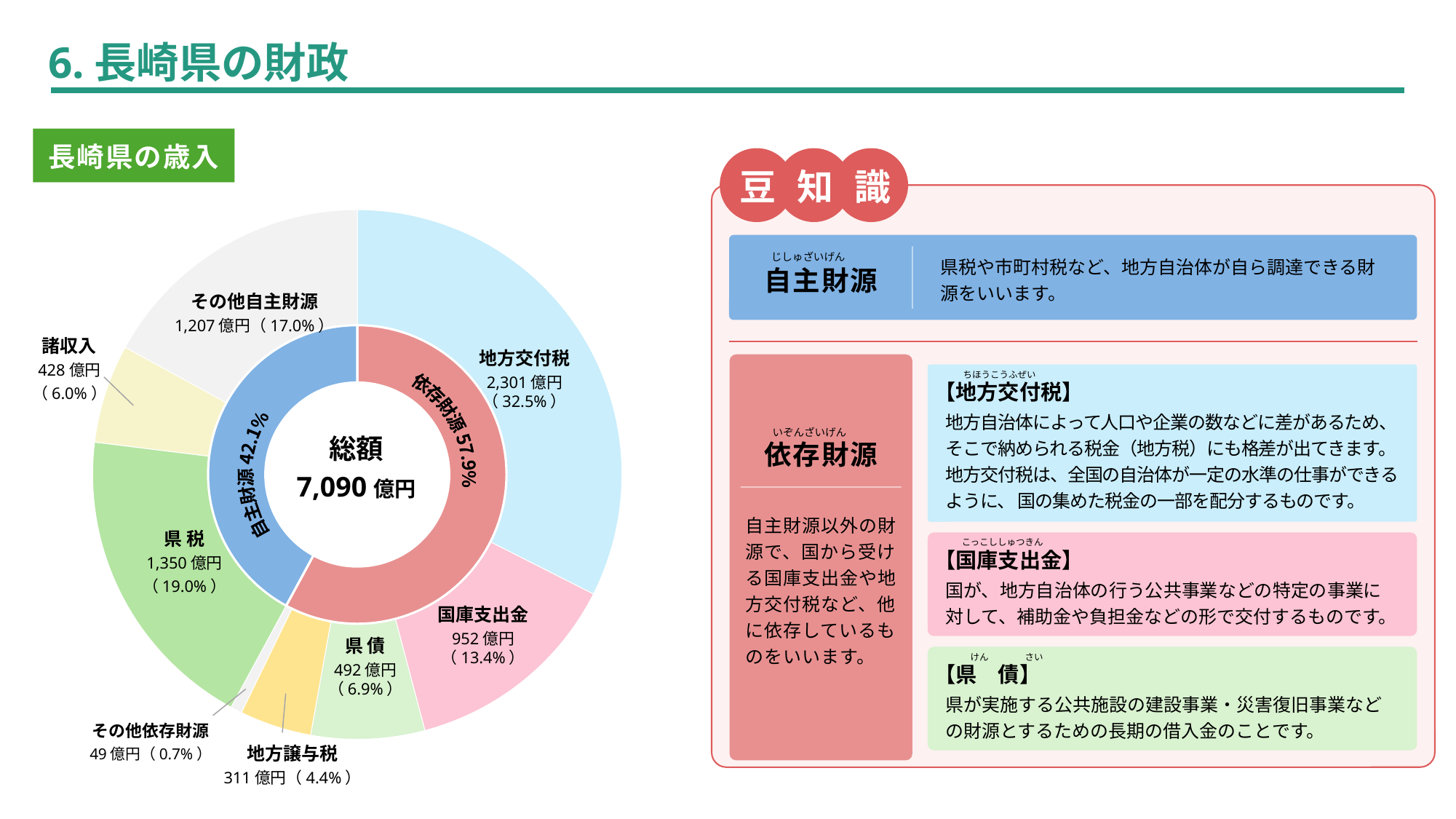
What kind of chart is the 長崎県の歳入 chart? Donut (pie) chart What is the total amount shown in the centre of the 長崎県の歳入 chart? 7,090 億円 Which category has the smallest value in the 長崎県の歳入 chart? その他依存財源 What is the difference between 地方交付税 and 県税 in the 長崎県の歳入 chart? 951 億円 What percentage of the total is 自主財源 in the 長崎県の歳入 chart? 42.1% Which is larger in the 長崎県の歳入 chart, 国庫支出金 or その他自主財源? その他自主財源 Which category has the largest value in the 長崎県の歳入 chart? 地方交付税 What is the value for 地方譲与税 in the 長崎県の歳入 chart? 311 億円 What percentage of the total is 依存財源 in the 長崎県の歳入 chart? 57.9% How many categories are shown in the outer ring of the 長崎県の歳入 chart? 8 What is the value for 地方交付税 in the 長崎県の歳入 chart? 2,301 億円 What share of the total does 県税 represent in the 長崎県の歳入 chart? 19.0%